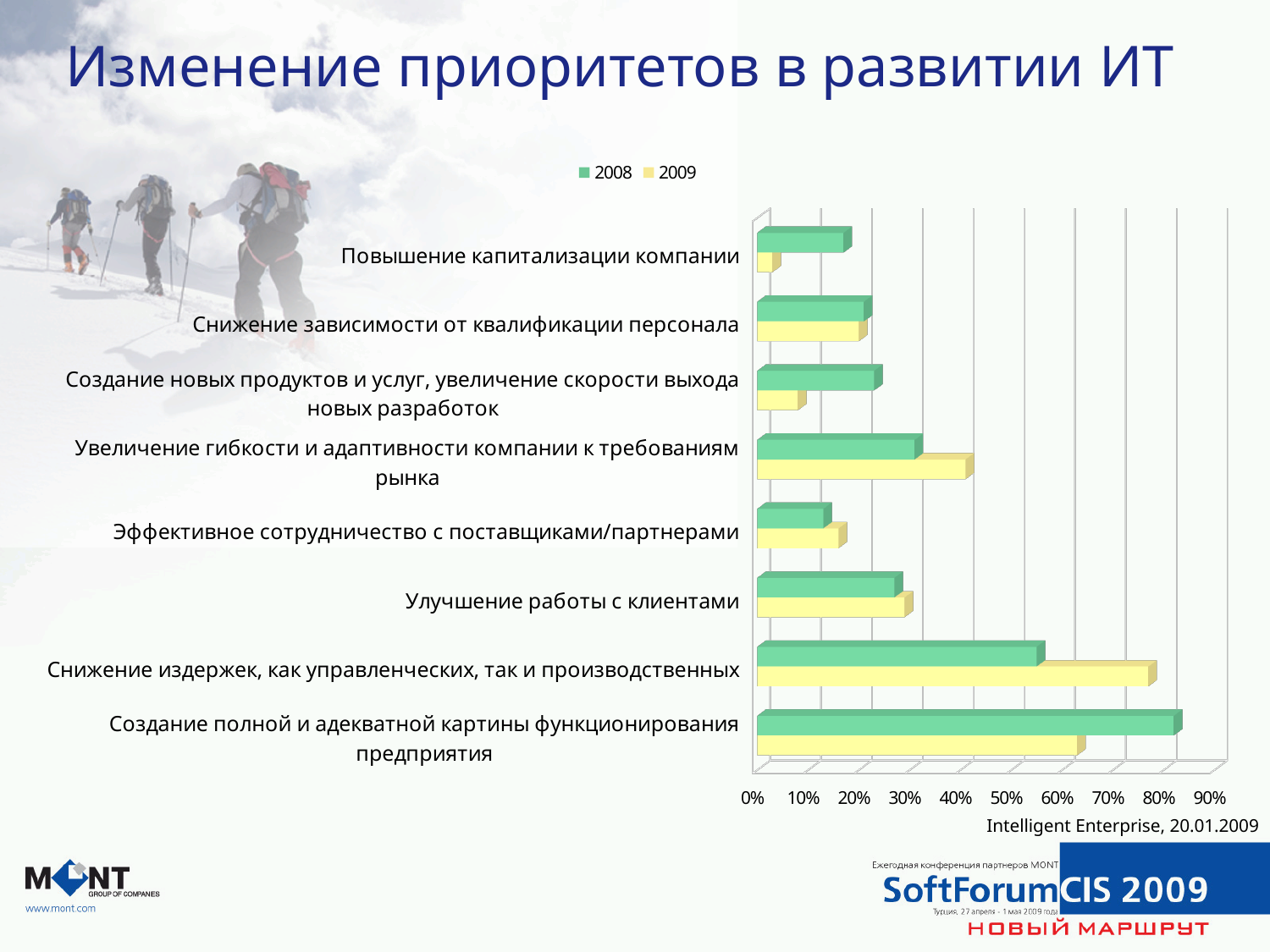
Is the 2009 value for 'Повышение капитализации компании' greater or less than 10%? less How many categories are plotted on the chart? 8 For 'Снижение издержек, как управленческих, так и производственных', which year has the larger value, 2008 or 2009? 2009 Which category has the highest value for 2008? Создание полной и адекватной картины функционирования предприятия How many series does the chart legend list? 2 Which category has the highest value for 2009? Снижение издержек, как управленческих, так и производственных What source is cited below the chart? Intelligent Enterprise, 20.01.2009 What kind of chart is shown on the slide? bar chart Is the 2009 value for 'Снижение издержек, как управленческих, так и производственных' greater or less than 70%? greater For 'Создание полной и адекватной картины функционирования предприятия', which year has the larger value, 2008 or 2009? 2008 Which series are listed in the chart legend? 2008 and 2009 Which category has the lowest value for 2009? Повышение капитализации компании